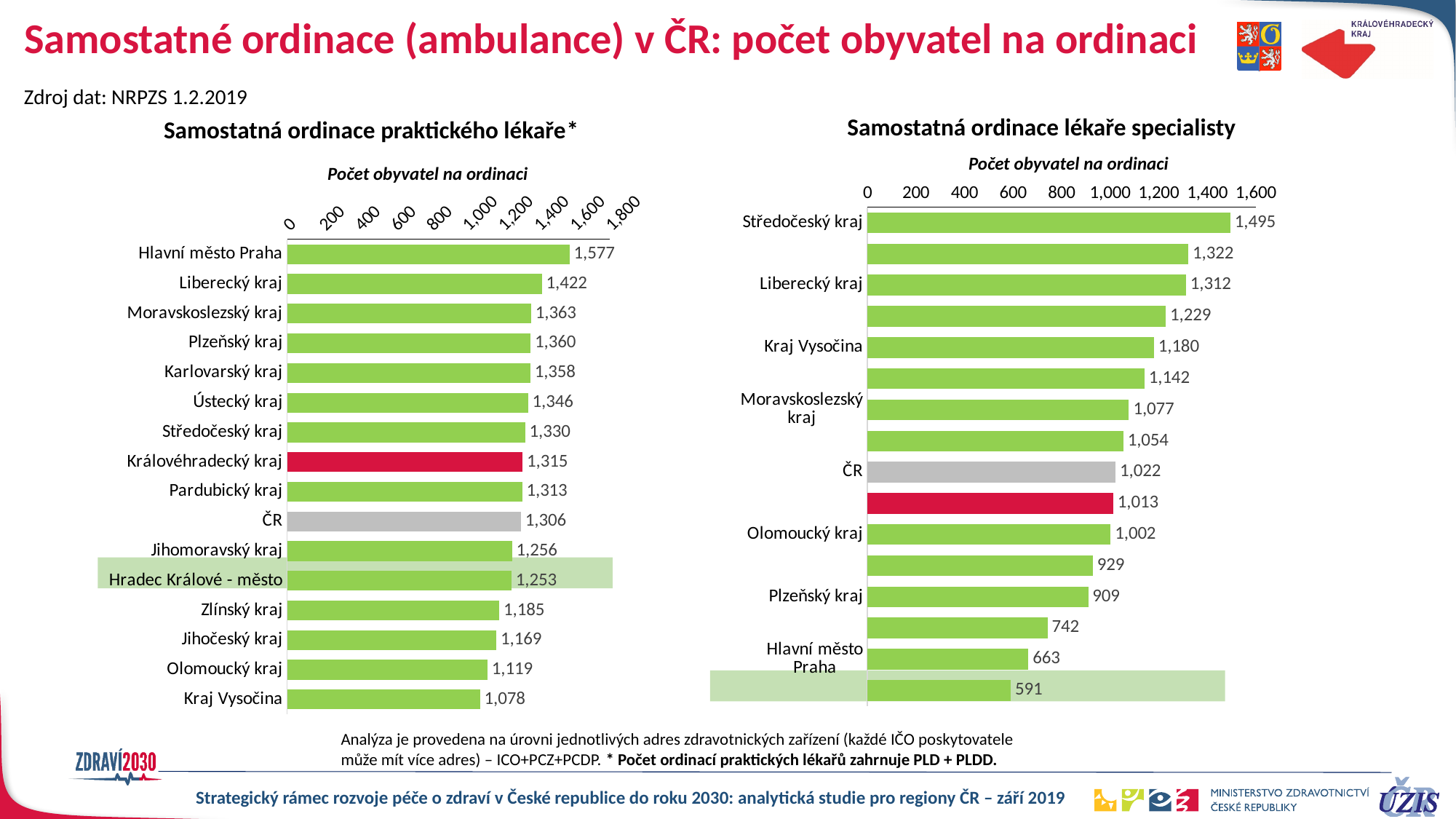
In the chart 'Samostatná ordinace lékaře specialisty', is the value for Plzeňský kraj greater or less than 1,000? less In the chart 'Samostatná ordinace lékaře specialisty', what is the value for ČR? 1,022 What type of chart is 'Samostatná ordinace lékaře specialisty'? bar chart In the chart 'Samostatná ordinace lékaře specialisty', what is the value for Hlavní město Praha? 663 In the chart 'Samostatná ordinace praktického lékaře', what is the value for Hlavní město Praha? 1,577 In the chart 'Samostatná ordinace praktického lékaře', which category has the lowest value? Kraj Vysočina In the chart 'Samostatná ordinace praktického lékaře', what is the value for Královéhradecký kraj? 1,315 In the chart 'Samostatná ordinace lékaře specialisty', which category has the highest value? Středočeský kraj How many categories are shown in the chart 'Samostatná ordinace praktického lékaře'? 16 In the chart 'Samostatná ordinace praktického lékaře', what is the difference between Hlavní město Praha and Kraj Vysočina? 499 In the chart 'Samostatná ordinace praktického lékaře', which is larger: Liberecký kraj or Moravskoslezský kraj? Liberecký kraj In the chart 'Samostatná ordinace lékaře specialisty', what is the difference between Středočeský kraj and Hlavní město Praha? 832